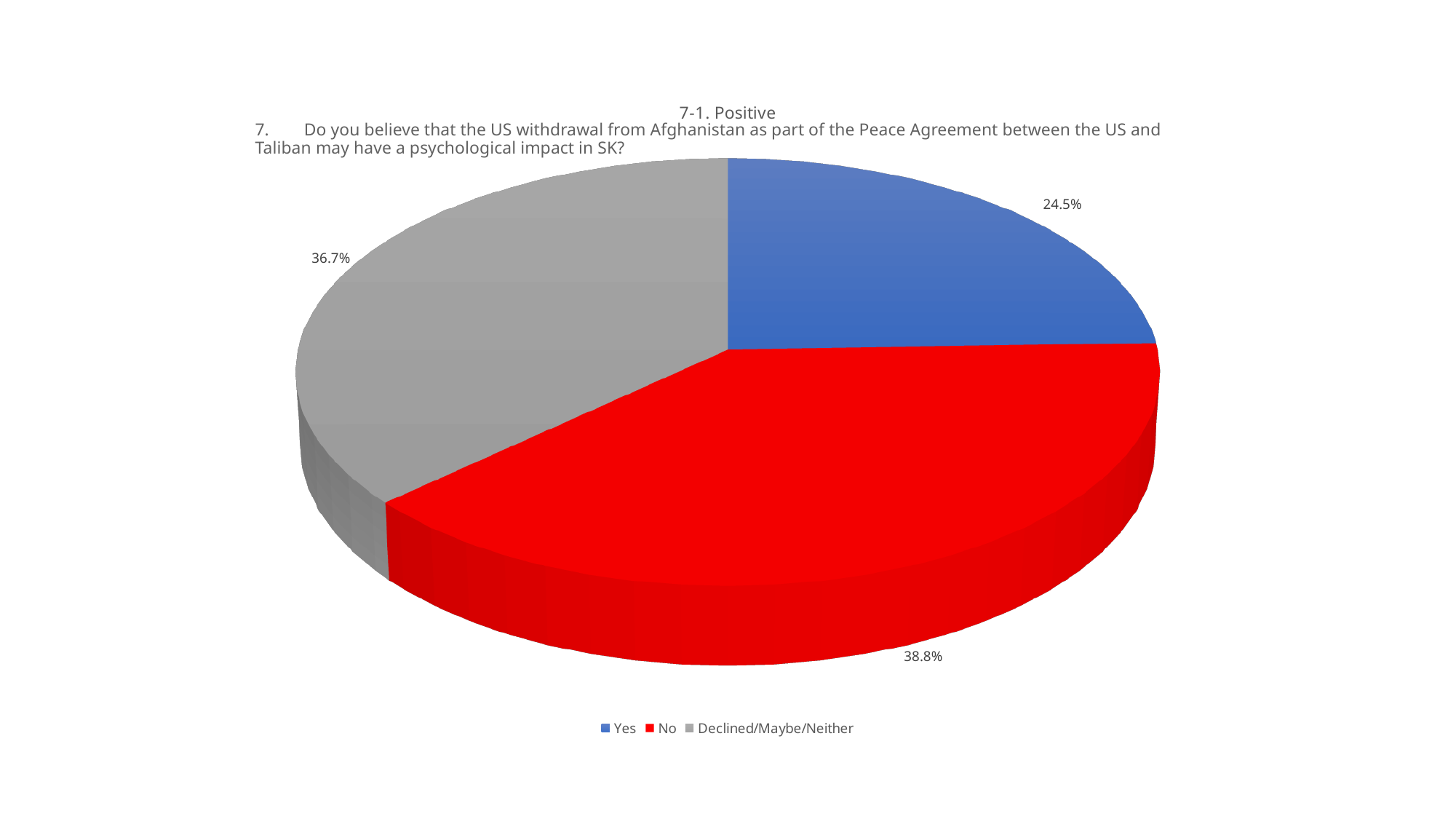
What percentage is shown for Declined/Maybe/Neither? 36.7% What is the difference in percentage points between the Declined/Maybe/Neither and Yes slices? 12.2 What is the difference in percentage points between the No and Yes slices? 14.3 Which is larger, the Yes slice or the Declined/Maybe/Neither slice? Declined/Maybe/Neither Which response has the smallest share of the pie? Yes What colour is the No slice? Red What is the title of the chart? 7-1. Positive What kind of chart is shown on the slide? Pie chart What percentage of respondents answered No? 38.8% What percentage of respondents answered Yes? 24.5% Which response has the largest share of the pie? No How many slices does the pie chart have? 3